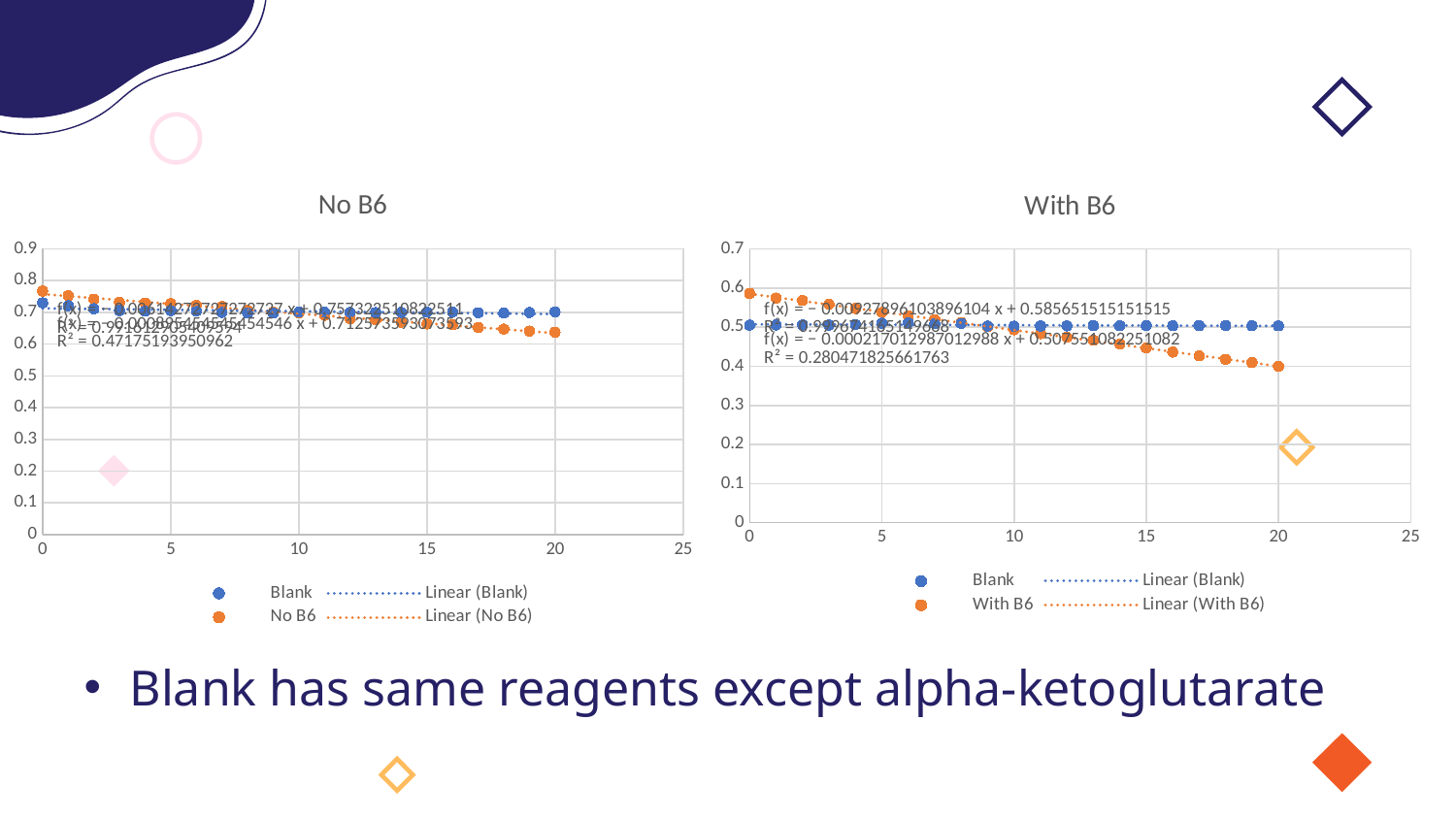
In the "No B6" chart, is the value of the No B6 series at x = 0 greater or less than 0.7? greater In the "No B6" chart, at x = 20, which series has the larger value, Blank or No B6? Blank What kind of chart is the "With B6" chart? scatter chart How many entries does the legend of the "No B6" chart list? 4 What is the highest value shown on the y axis of the "No B6" chart? 0.9 In the "With B6" chart, is the value of the With B6 series at x = 20 greater or less than 0.5? less What kind of chart is the "No B6" chart? scatter chart In the "With B6" chart, do the values of the With B6 series rise or fall as x increases? fall How many entries does the legend of the "With B6" chart list? 4 In the "With B6" chart, is the value of the With B6 series at x = 0 greater or less than 0.5? greater In the "With B6" chart, at x = 20, which series has the larger value, Blank or With B6? Blank In the "No B6" chart, do the values of the No B6 series rise or fall as x increases? fall